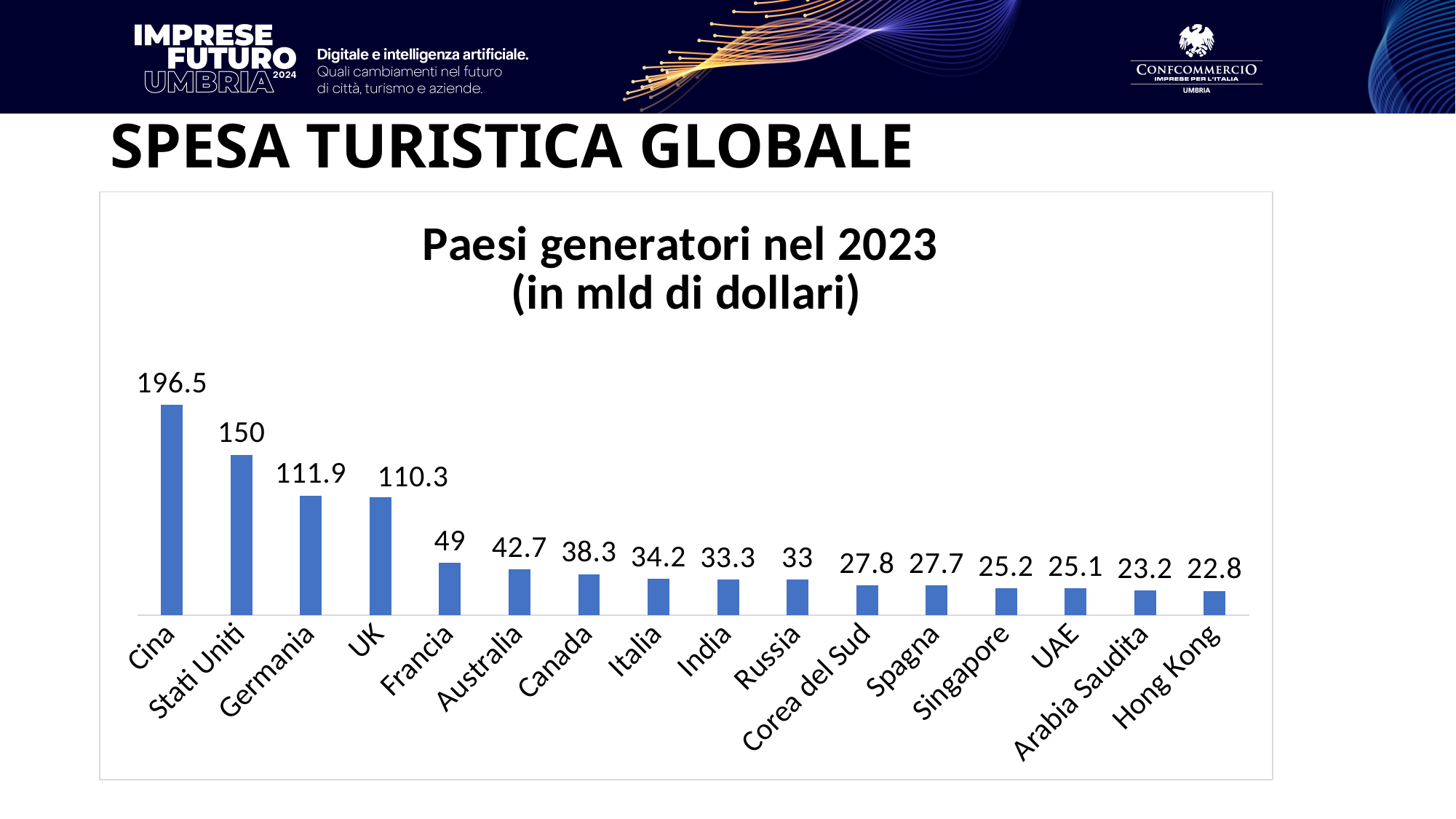
What is the value for Arabia Saudita? 23.2 What is the value for Italia? 34.2 What is the difference between the values for Cina and Stati Uniti? 46.5 Which is larger, the value for India or the value for Canada? Canada Which country has the highest value? Cina How many countries are shown in the chart? 16 Which country has the lowest value? Hong Kong What is the difference between the values for Francia and Australia? 6.3 What is the title of the chart? Paesi generatori nel 2023 (in mld di dollari) What is the value for Cina? 196.5 Which is larger, the value for Germania or the value for UK? Germania What kind of chart is this? Bar chart